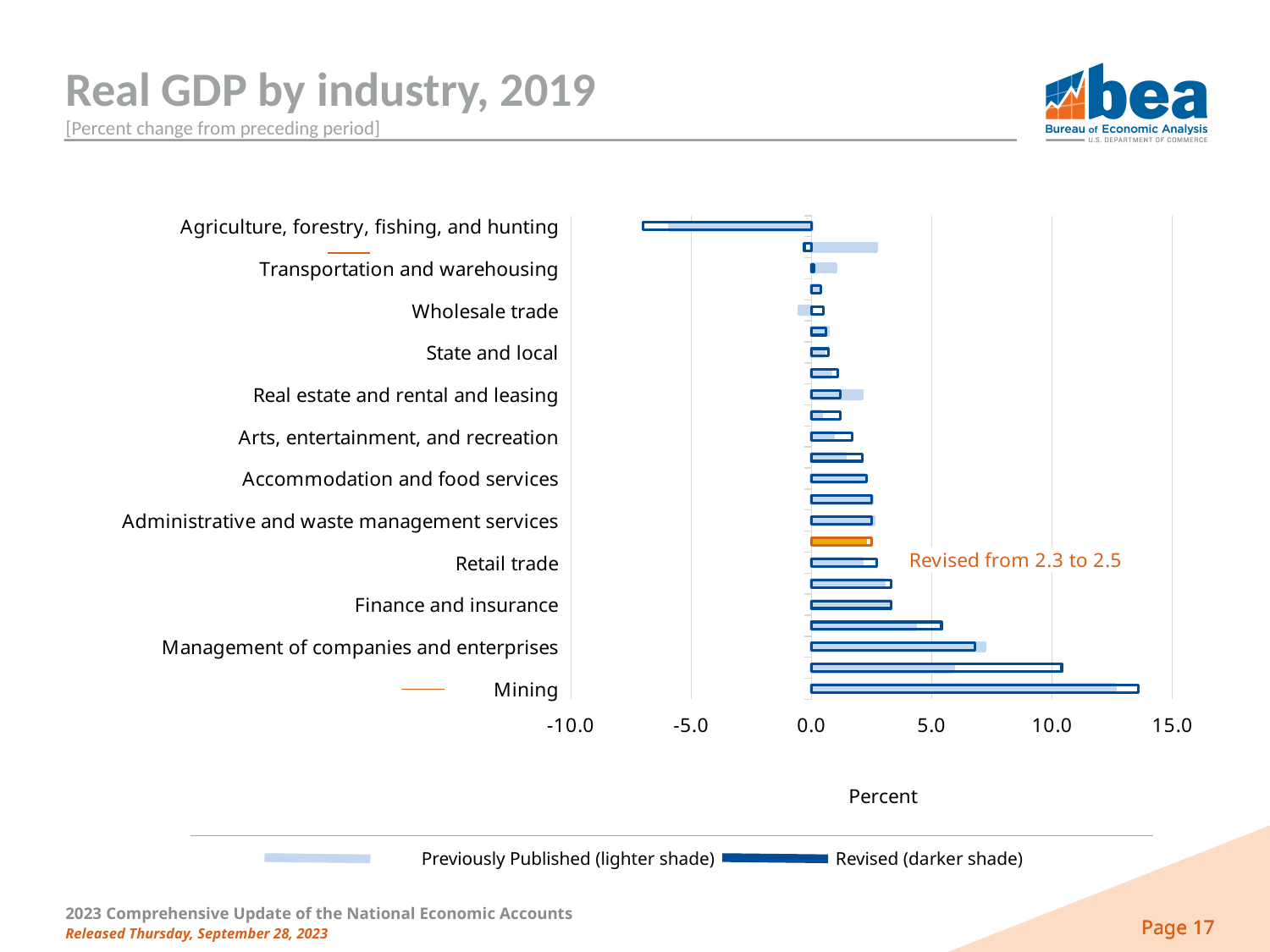
Which labeled industry has the lowest revised value? Agriculture, forestry, fishing, and hunting Is the revised value for Agriculture, forestry, fishing, and hunting greater or less than -5.0? less Is the revised value for Finance and insurance greater or less than 5.0? less Is the revised value for Mining greater or less than 10.0? greater What kind of chart is shown on the slide? Bar chart What are the two series named in the legend? Previously Published (lighter shade) and Revised (darker shade) How many series does the legend list? 2 Which labeled industry has the highest revised value? Mining Which has the larger revised value, Management of companies and enterprises or Retail trade? Management of companies and enterprises Do the revised bars get larger or smaller moving from the top of the chart to the bottom? Larger What does the orange annotation on the chart say? Revised from 2.3 to 2.5 For Agriculture, forestry, fishing, and hunting, which is larger: the previously published value or the revised value? Previously published